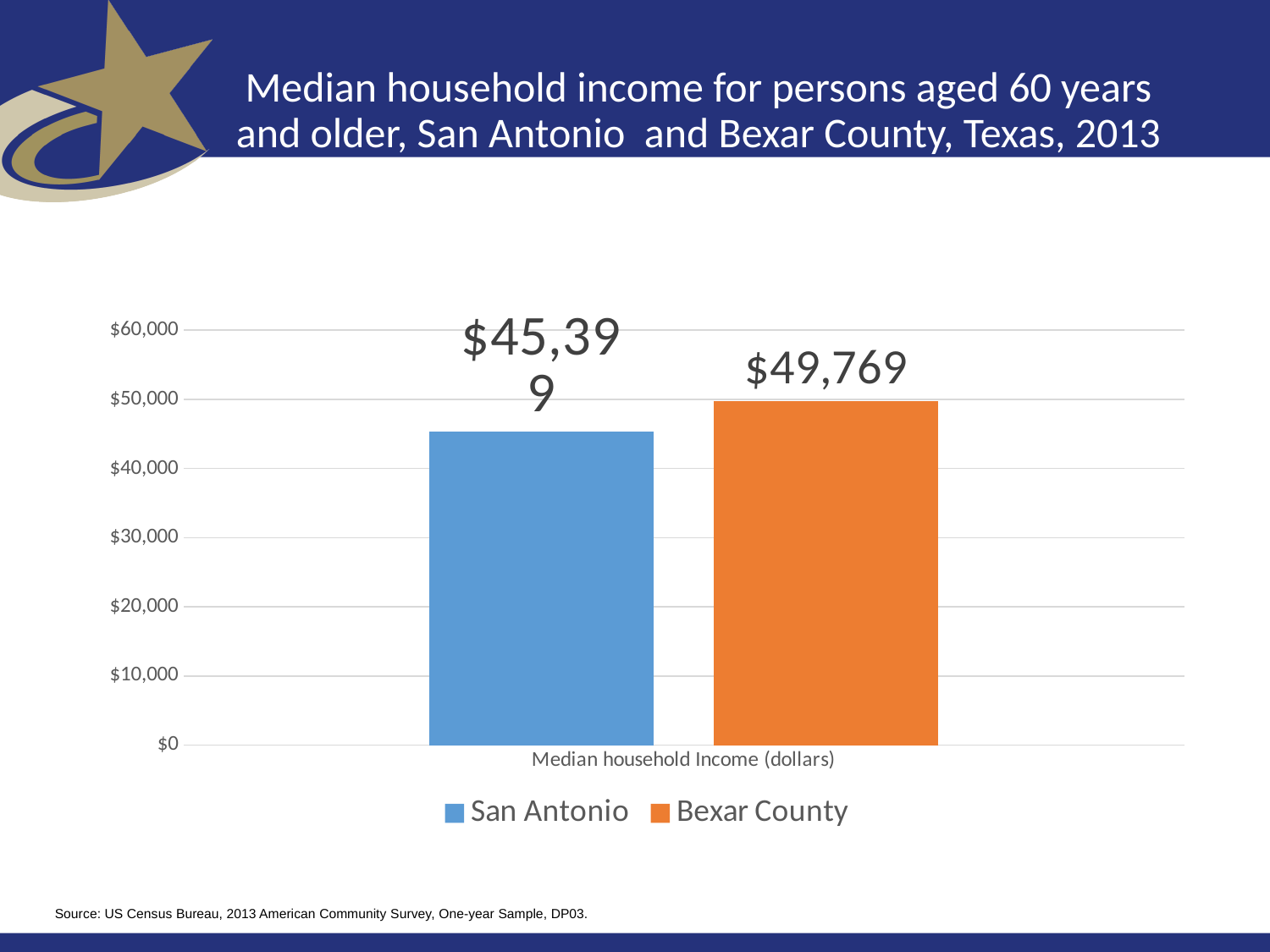
Is the value for San Antonio greater or less than $50,000? less How many series does the legend list? 2 Which series has the highest median household income? Bexar County What is the median household income for San Antonio? $45,399 Which series has the lowest median household income? San Antonio What is the label on the x axis of the chart? Median household Income (dollars) What is the median household income for Bexar County? $49,769 Which series has the higher median household income, San Antonio or Bexar County? Bexar County What is the difference between the Bexar County and San Antonio median household incomes? $4,370 Is the value for Bexar County greater or less than $40,000? greater What colour is the bar for Bexar County? orange What kind of chart is shown on the slide? bar chart